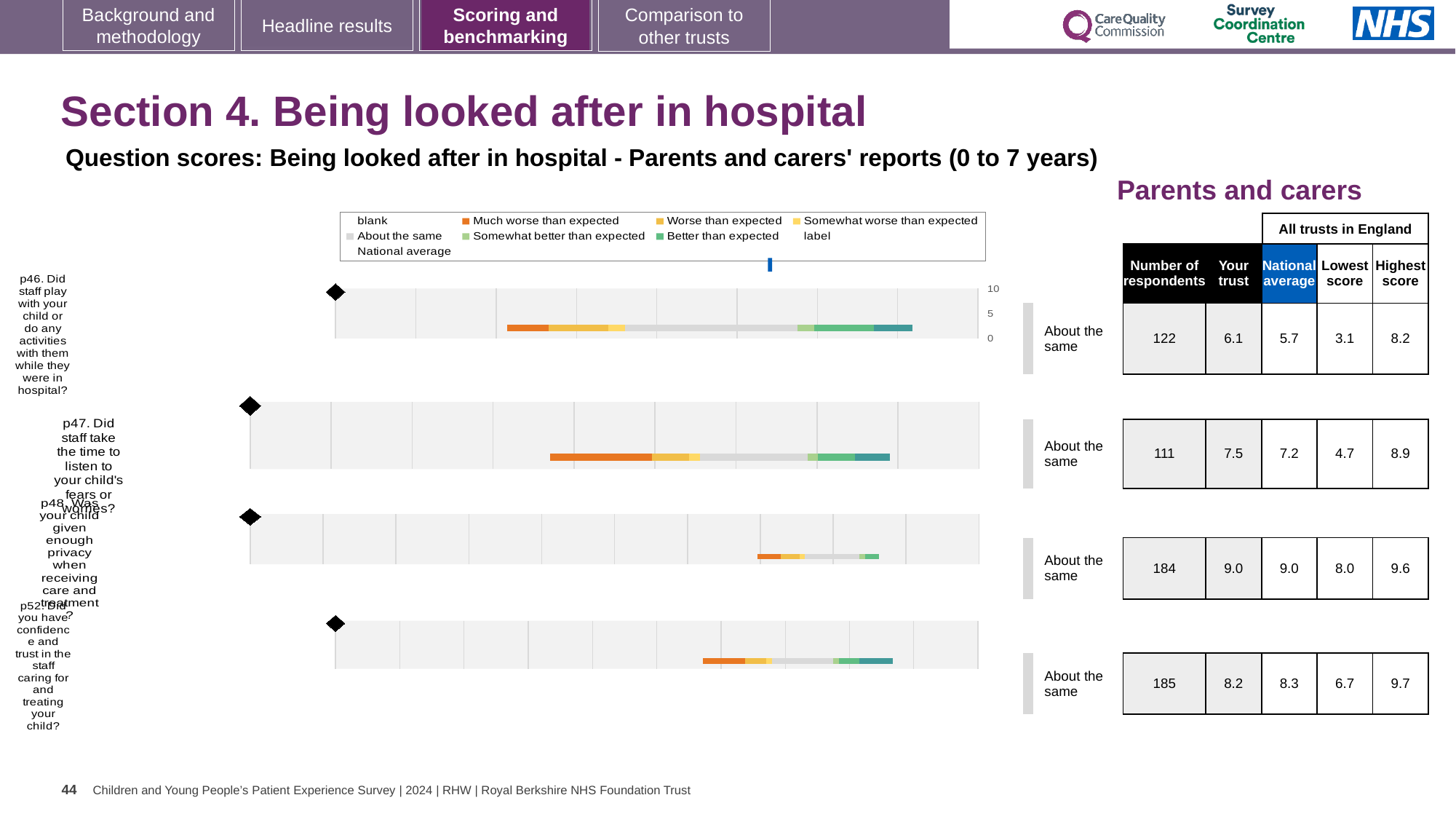
For the p52 chart, what is the highest score among all trusts in England? 9.7 For the p47 chart (Did staff take the time to listen to your child's fears or worries?), what is the national average score? 7.2 Which question chart has the highest 'Your trust' score? p48. Was your child given enough privacy when receiving care and treatment? Which question chart has the lowest 'Your trust' score? p46. Did staff play with your child or do any activities with them while they were in hospital? What benchmark category is shown next to the p46 chart? About the same For the p47 chart, how much higher is the 'Your trust' score than the national average? 0.3 What kind of chart is used to show the question scores on this slide? bar chart How many question charts are shown on the slide? 4 For the p46 chart, what is the difference between the highest score and the lowest score among all trusts in England? 5.1 For the p52 chart (Did you have confidence and trust in the staff caring for and treating your child?), which is larger: the 'Your trust' score or the national average? National average For the p48 chart, how many respondents are there? 184 For the p46 chart (Did staff play with your child or do any activities with them while they were in hospital?), what is the 'Your trust' score? 6.1